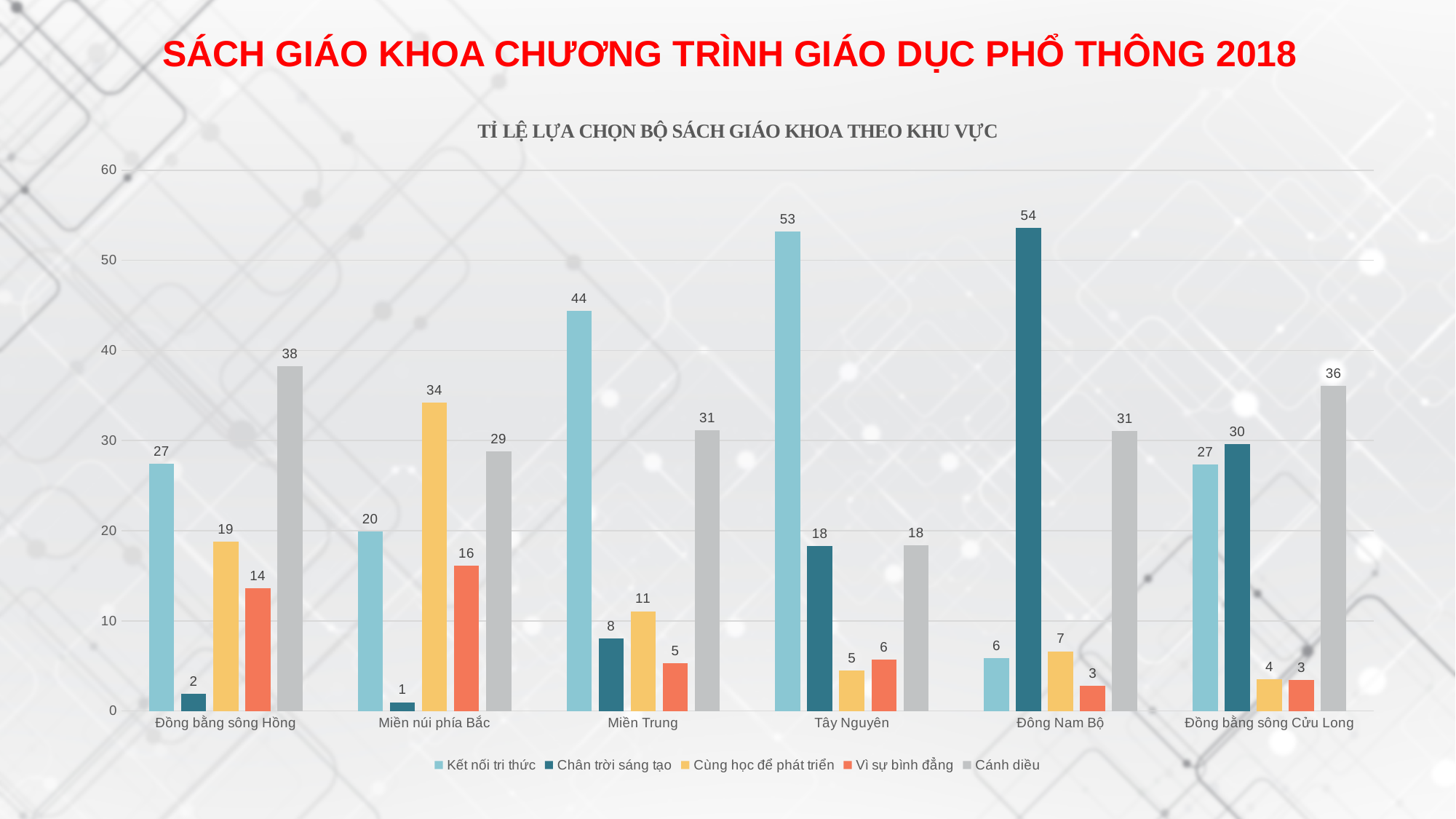
What is the value for Cánh diều in Đồng bằng sông Hồng? 38 Which is larger in Đồng bằng sông Cửu Long: Chân trời sáng tạo or Kết nối tri thức? Chân trời sáng tạo How many series does the legend list? 5 What kind of chart is shown on the slide? Bar chart Which region has the lowest value for Kết nối tri thức? Đông Nam Bộ What is the value for Kết nối tri thức in Tây Nguyên? 53 Which region has the highest value for Chân trời sáng tạo? Đông Nam Bộ How many regions are shown on the x axis? 6 What is the difference between Kết nối tri thức and Cánh diều in Miền Trung? 13 What is the title of the chart? TỈ LỆ LỰA CHỌN BỘ SÁCH GIÁO KHOA THEO KHU VỰC What is the value for Cùng học để phát triển in Miền núi phía Bắc? 34 What is the value for Vì sự bình đẳng in Đông Nam Bộ? 3